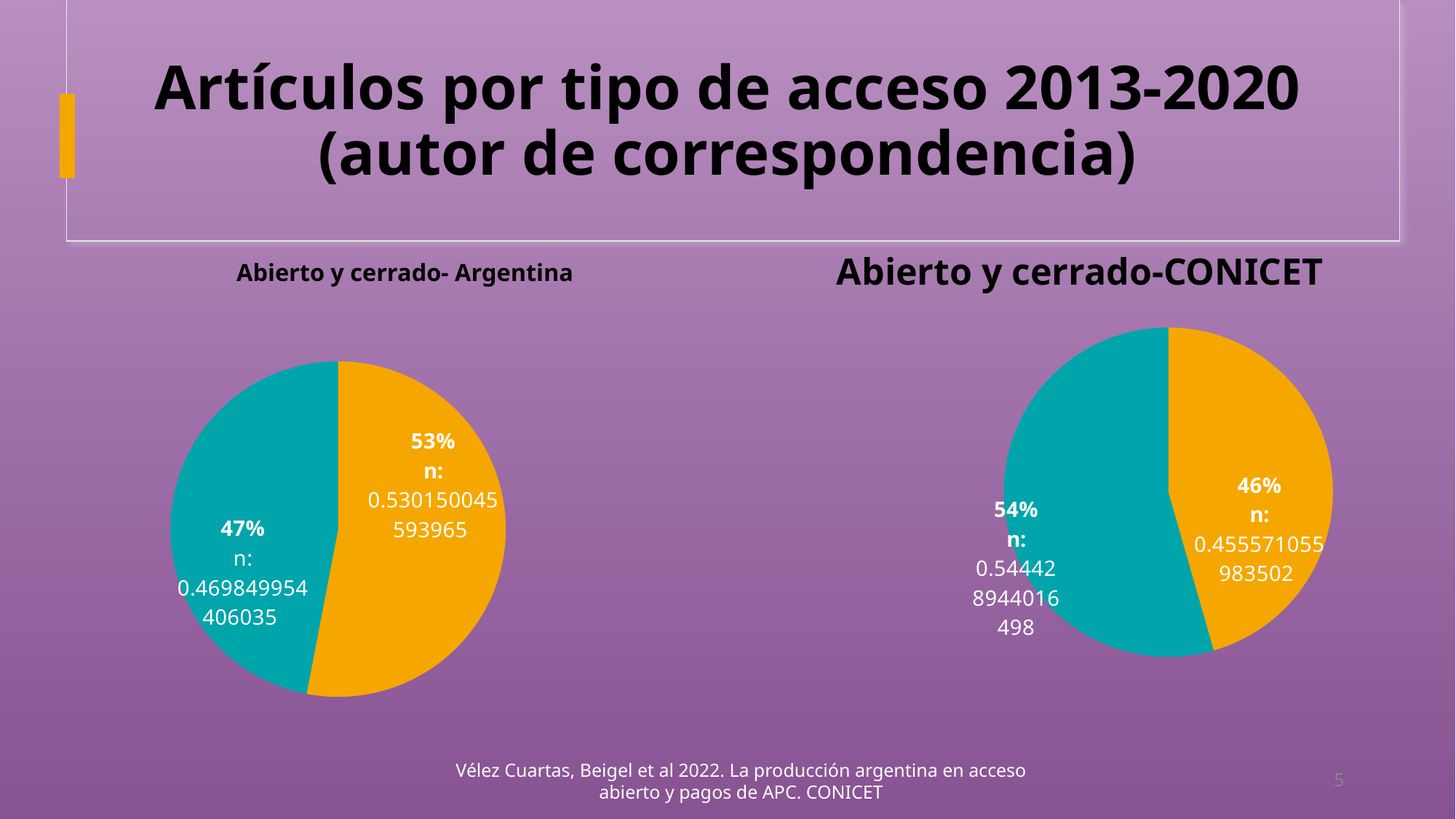
In the "Abierto y cerrado- Argentina" chart, what share does the orange slice represent? 53% In the "Abierto y cerrado-CONICET" chart, what share does the orange slice represent? 46% In the "Abierto y cerrado- Argentina" chart, what share does the teal slice represent? 47% Which is larger: the orange slice in the "Abierto y cerrado- Argentina" chart or the orange slice in the "Abierto y cerrado-CONICET" chart? Abierto y cerrado- Argentina In the "Abierto y cerrado- Argentina" chart, which colour slice is the largest? orange What is the title of the pie chart on the right side of the slide? Abierto y cerrado-CONICET In the "Abierto y cerrado-CONICET" chart, which colour slice is the smallest? orange What kind of chart is the "Abierto y cerrado- Argentina" chart? pie chart In the "Abierto y cerrado- Argentina" chart, what is the difference in percentage points between the orange slice and the teal slice? 6 How many slices does the "Abierto y cerrado-CONICET" pie chart have? 2 How many slices does the "Abierto y cerrado- Argentina" pie chart have? 2